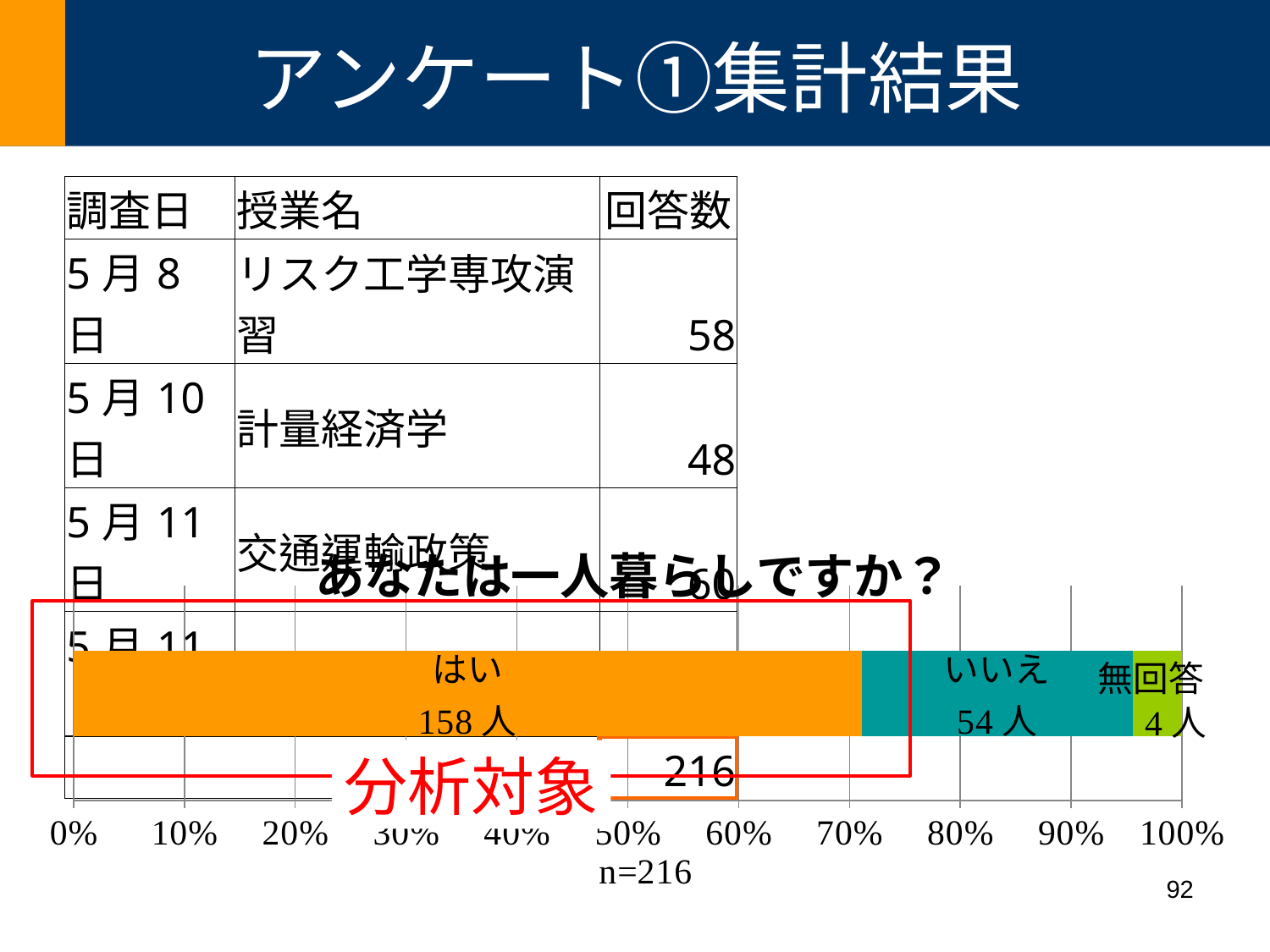
In the chart 'あなたは一人暮らしですか？', how many people answered いいえ? 54人 In the chart 'あなたは一人暮らしですか？', what is the total number of respondents across all three segments? 216 In the chart 'あなたは一人暮らしですか？', is the share of the はい segment greater or less than 60%? greater What kind of chart is shown below the table on the slide? bar chart In the chart 'あなたは一人暮らしですか？', how many more people answered はい than いいえ? 104人 In the chart 'あなたは一人暮らしですか？', how many response segments make up the stacked bar? 3 In the chart 'あなたは一人暮らしですか？', which response has the smallest number of people? 無回答 In the chart 'あなたは一人暮らしですか？', how many people answered はい? 158人 In the chart 'あなたは一人暮らしですか？', which is larger: the number for いいえ or the number for 無回答? いいえ What is the title of the bar chart on the slide? あなたは一人暮らしですか？ In the chart 'あなたは一人暮らしですか？', which response has the largest number of people? はい In the chart 'あなたは一人暮らしですか？', how many people gave 無回答? 4人